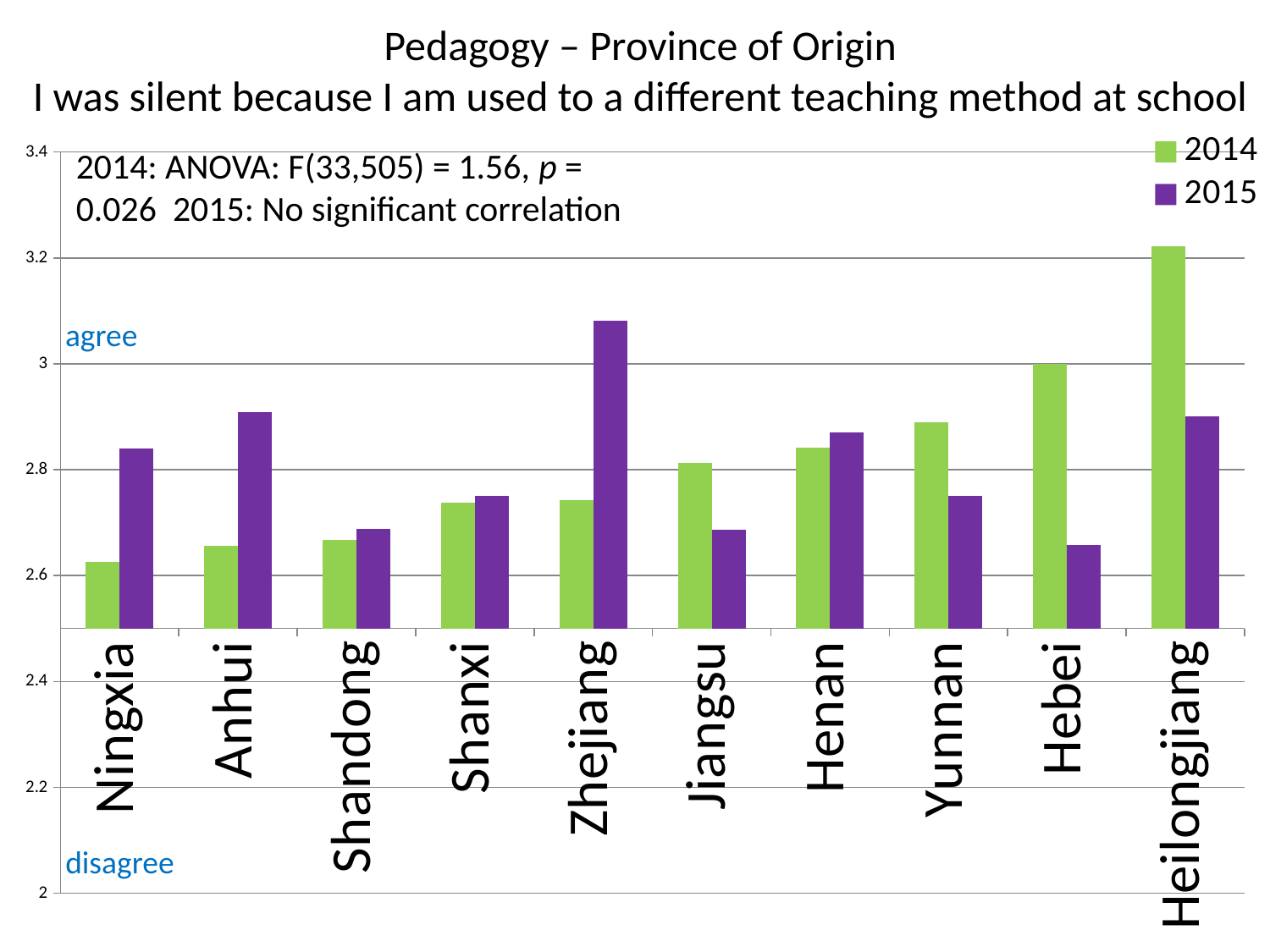
What kind of chart is shown on the slide? bar chart Which province has the highest value for 2015? Zhejiang How many provinces are shown on the x axis of the chart? 10 For Ningxia, which series has the larger value, 2014 or 2015? 2015 Is the 2014 value for Heilongjiang greater or less than 3? greater How many series does the chart's legend list? 2 Which province has the lowest value for 2014? Ningxia What colour are the bars for the 2014 series? green For Hebei, which series has the larger value, 2014 or 2015? 2014 Is the 2015 value for Anhui greater or less than 2.8? greater Is the 2015 value for Hebei greater or less than 2.8? less Which province has the highest value for 2014? Heilongjiang